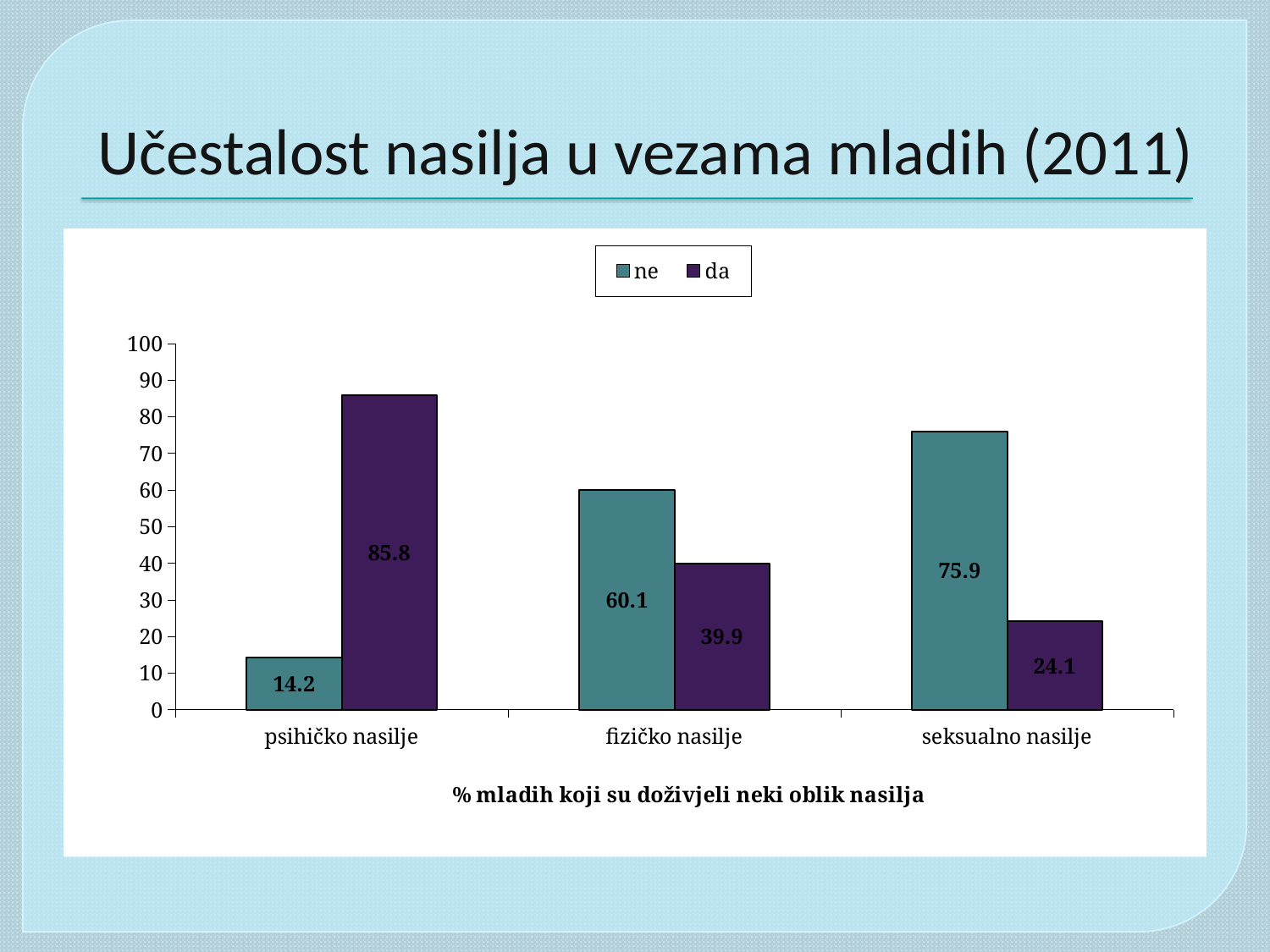
What is the x-axis title of the chart? % mladih koji su doživjeli neki oblik nasilja What kind of chart is shown on the slide? bar chart What is the value of "da" for psihičko nasilje? 85.8 What is the value of "ne" for fizičko nasilje? 60.1 Which category has the highest "da" value? psihičko nasilje How many series does the legend list? 2 What is the difference between the "ne" and "da" values for fizičko nasilje? 20.2 What is the value of "da" for seksualno nasilje? 24.1 How many categories are shown on the x axis? 3 Which category has the lowest "ne" value? psihičko nasilje What is the value of "ne" for psihičko nasilje? 14.2 For seksualno nasilje, which is larger: "ne" or "da"? ne